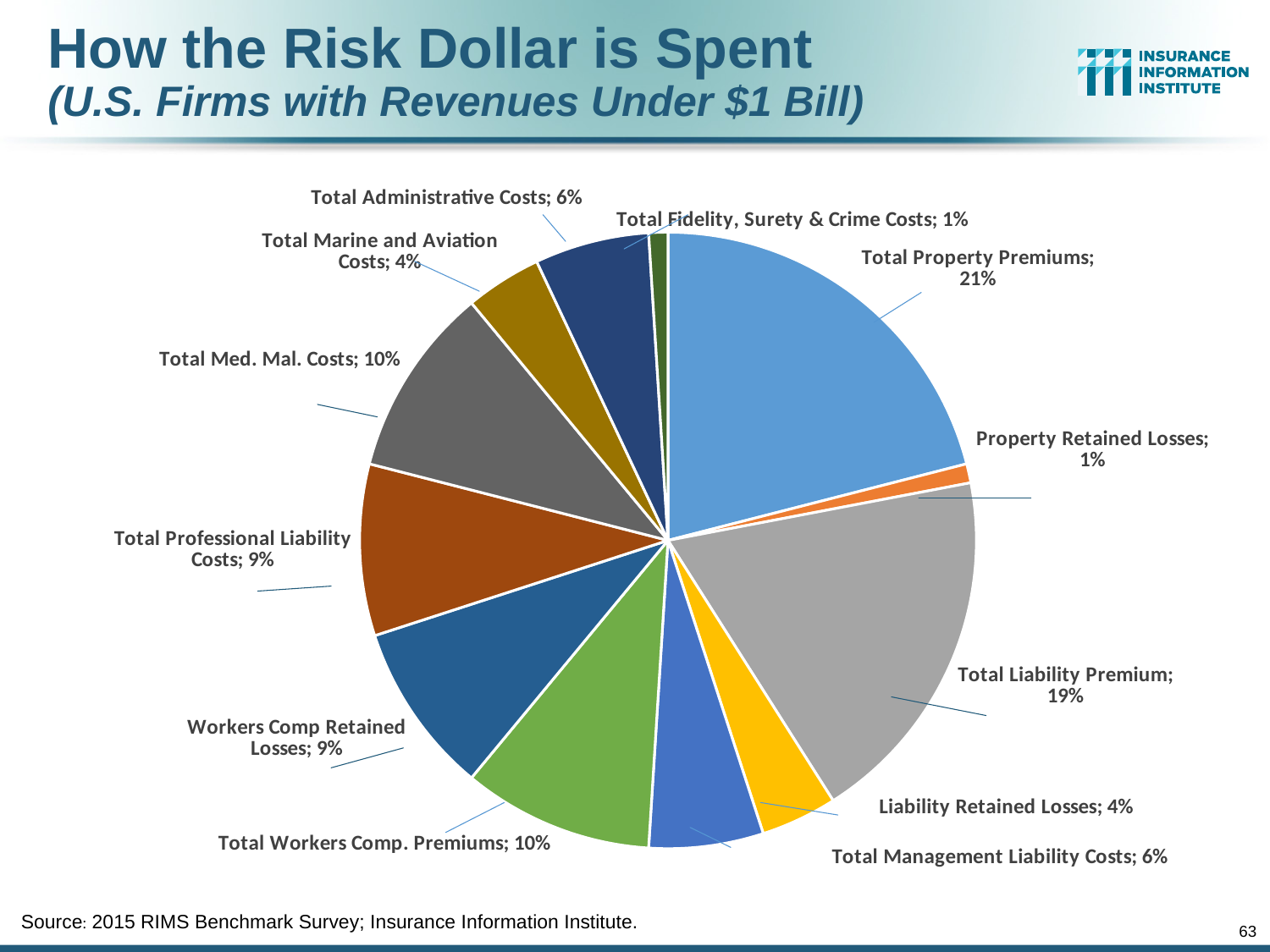
What share of the risk dollar goes to Total Property Premiums? 21% What kind of chart is shown on the slide? pie chart Which category has the largest share of the pie? Total Property Premiums What is the title of the chart on the slide? How the Risk Dollar is Spent (U.S. Firms with Revenues Under $1 Bill) What percentage is shown for Total Med. Mal. Costs? 10% What percentage is shown for Total Liability Premium? 19% What percentage is shown for Total Marine and Aviation Costs? 4% What is the combined share of Total Administrative Costs and Total Management Liability Costs? 12% How many slices does the pie chart have? 12 What is the difference in percentage points between Total Property Premiums and Total Liability Premium? 2 What percentage is shown for Workers Comp Retained Losses? 9% Which is larger, Total Workers Comp. Premiums or Total Management Liability Costs? Total Workers Comp. Premiums